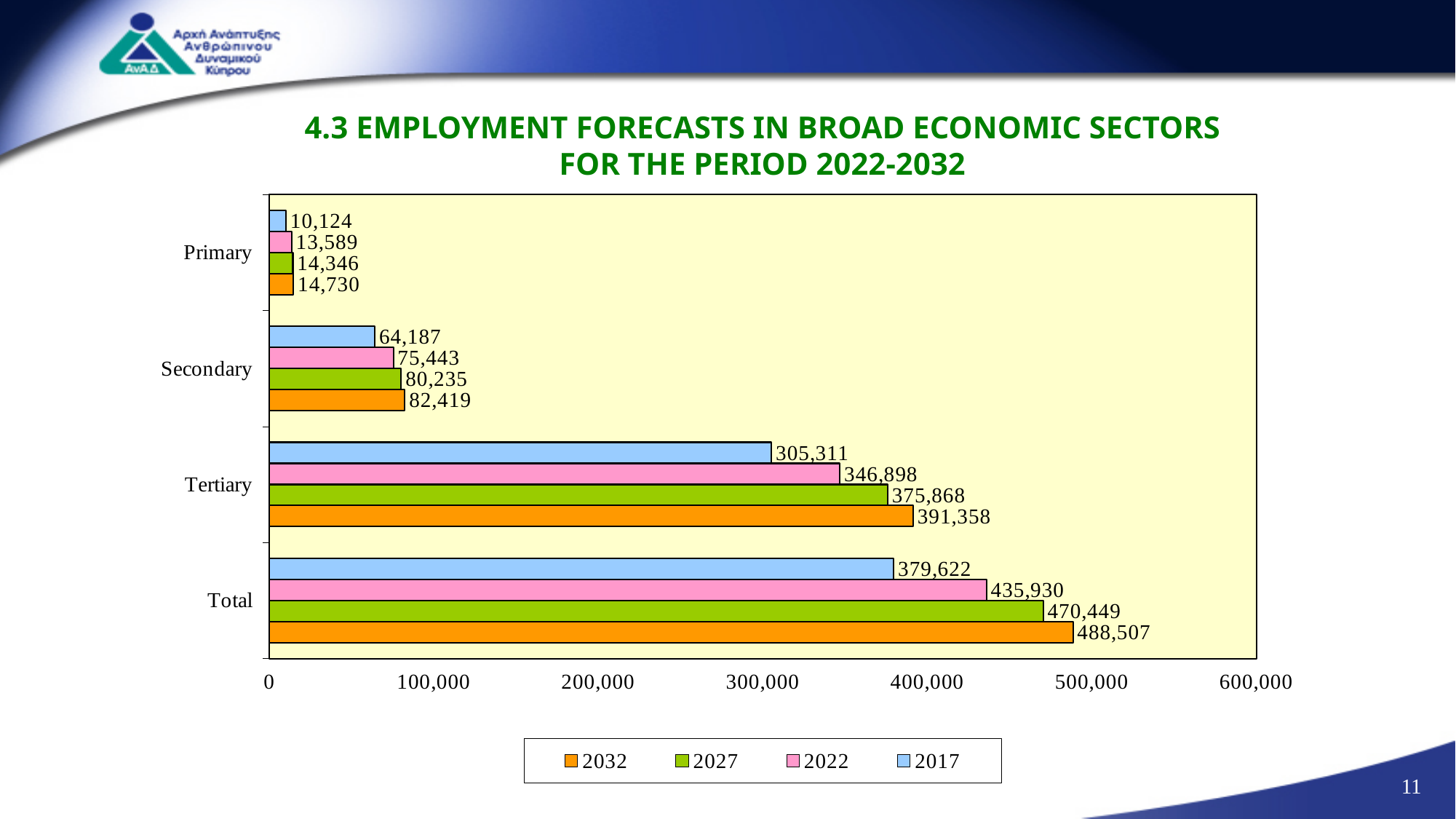
What is the difference between the Total values for 2032 and 2017? 108,885 What is the value for the Secondary sector in 2027? 80,235 What is the Total value for 2022? 435,930 What is the difference between the Tertiary values for 2032 and 2027? 15,490 What type of chart is shown on the slide? Bar chart How many series does the legend list? 4 What is the value for the Primary sector in 2017? 10,124 Which sector (excluding Total) has the highest employment in 2017? Tertiary Which sector (excluding Total) has the lowest employment in 2032? Primary Which is larger: the Secondary value for 2022 or the Secondary value for 2017? 2022 Which colour represents the 2027 series in the legend? Green What is the employment forecast for the Tertiary sector in 2032? 391,358